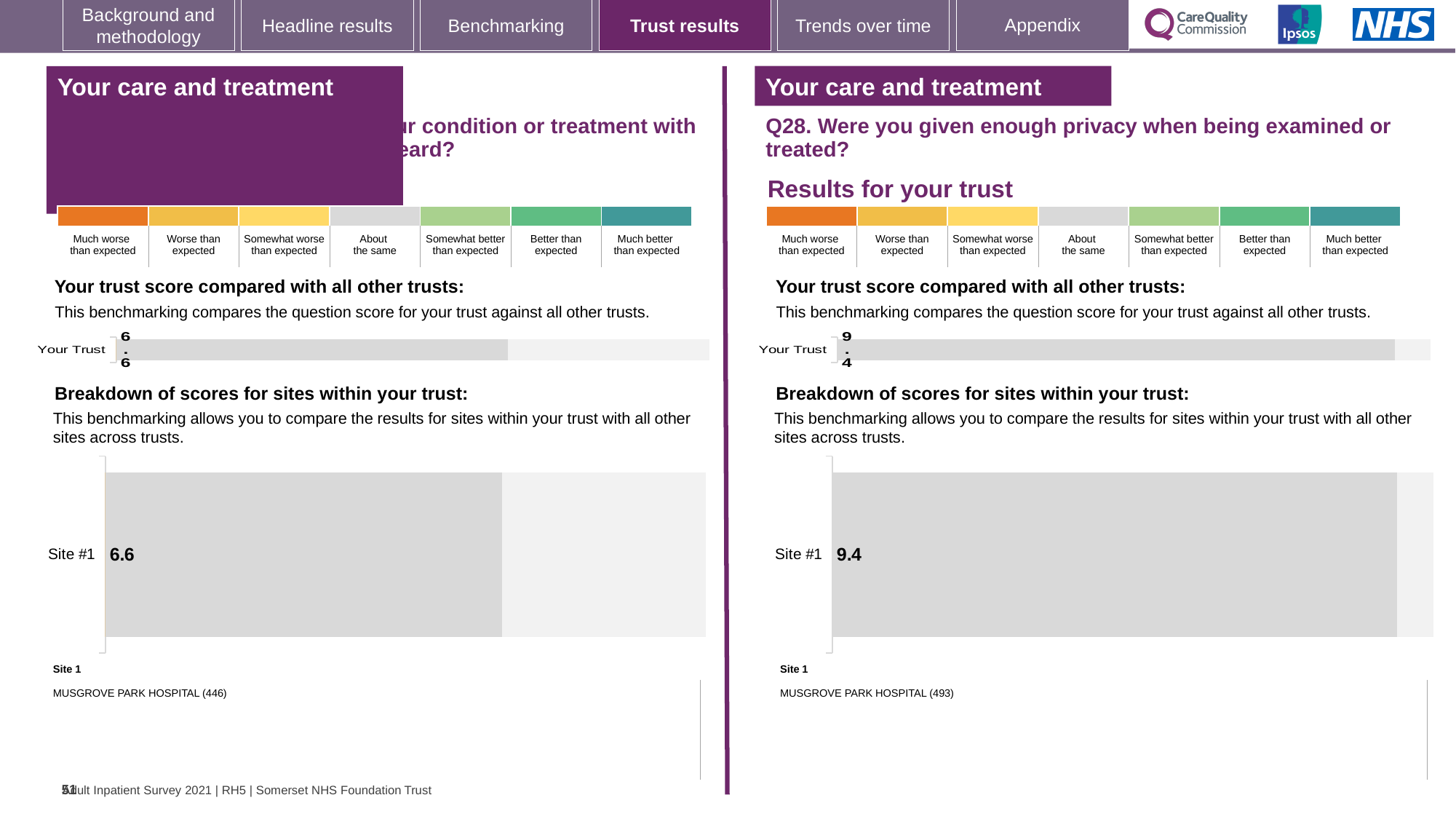
Which is larger: the Site #1 score on the left-hand breakdown chart or the Site #1 score on the right-hand Q28 breakdown chart? Right-hand Q28 chart (9.4) On the left-hand 'Your trust score compared with all other trusts' chart, what is the score for Your Trust? 6.6 Which hospital is listed as Site 1 beneath the right-hand Q28 breakdown chart? MUSGROVE PARK HOSPITAL (493) What is the difference between the Your Trust score on the right-hand Q28 chart and the Your Trust score on the left-hand chart? 2.8 On the left-hand 'Breakdown of scores for sites within your trust' chart, what is the score for Site #1? 6.6 What kind of chart is used to show the Site #1 score on the right-hand Q28 breakdown chart? Bar chart On the right-hand Q28 'Breakdown of scores for sites within your trust' chart, what is the score for Site #1? 9.4 On the right-hand Q28 'Your trust score compared with all other trusts' chart, what is the score for Your Trust? 9.4 Which hospital is listed as Site 1 beneath the left-hand breakdown chart? MUSGROVE PARK HOSPITAL (446) How many sites are shown on the left-hand 'Breakdown of scores for sites within your trust' chart? 1 How many sites are shown on the right-hand Q28 'Breakdown of scores for sites within your trust' chart? 1